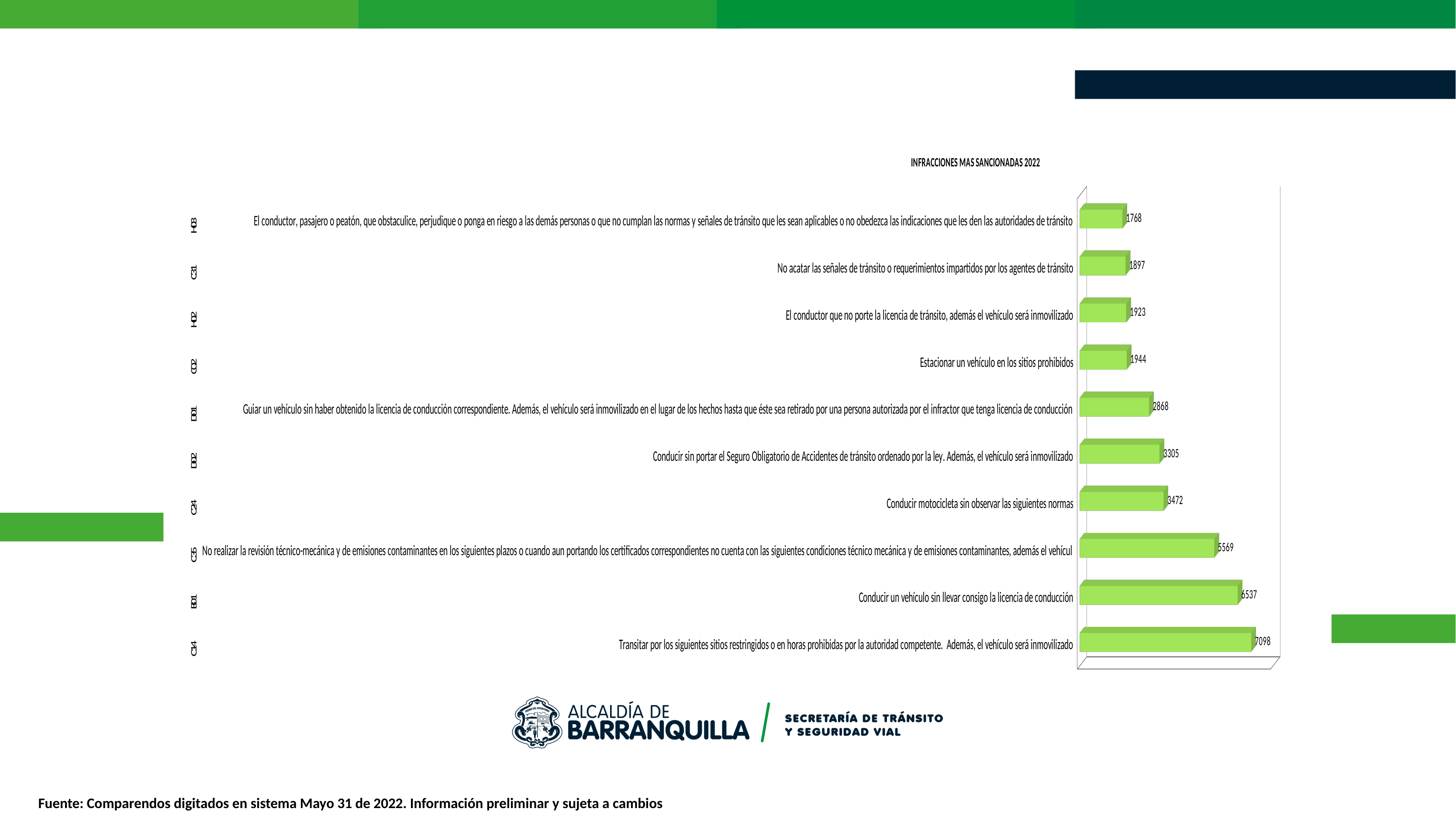
What is the title of the chart? INFRACCIONES MAS SANCIONADAS 2022 How many infraction categories are plotted in the chart? 10 What is the value for "Estacionar un vehículo en los sitios prohibidos" (C02)? 1944 What is the value for "Conducir motocicleta sin observar las siguientes normas" (C24)? 3472 What is the difference between the values for C14 (7098) and B01 (6537)? 561 Which has a larger value: "Conducir sin portar el Seguro Obligatorio de Accidentes de tránsito" (D02) or "Guiar un vehículo sin haber obtenido la licencia de conducción" (D01)? Conducir sin portar el Seguro Obligatorio de Accidentes de tránsito (D02) What is the value for "Transitar por los siguientes sitios restringidos o en horas prohibidas por la autoridad competente" (C14)? 7098 What kind of chart is shown on the slide? Bar chart What is the value for "No acatar las señales de tránsito o requerimientos impartidos por los agentes de tránsito" (C31)? 1897 Which infraction has the highest value in the chart? Transitar por los siguientes sitios restringidos o en horas prohibidas por la autoridad competente (C14) What is the value for "Conducir un vehículo sin llevar consigo la licencia de conducción" (B01)? 6537 Which infraction has the lowest value in the chart? El conductor, pasajero o peatón, que obstaculice, perjudique o ponga en riesgo a las demás personas... (H03)